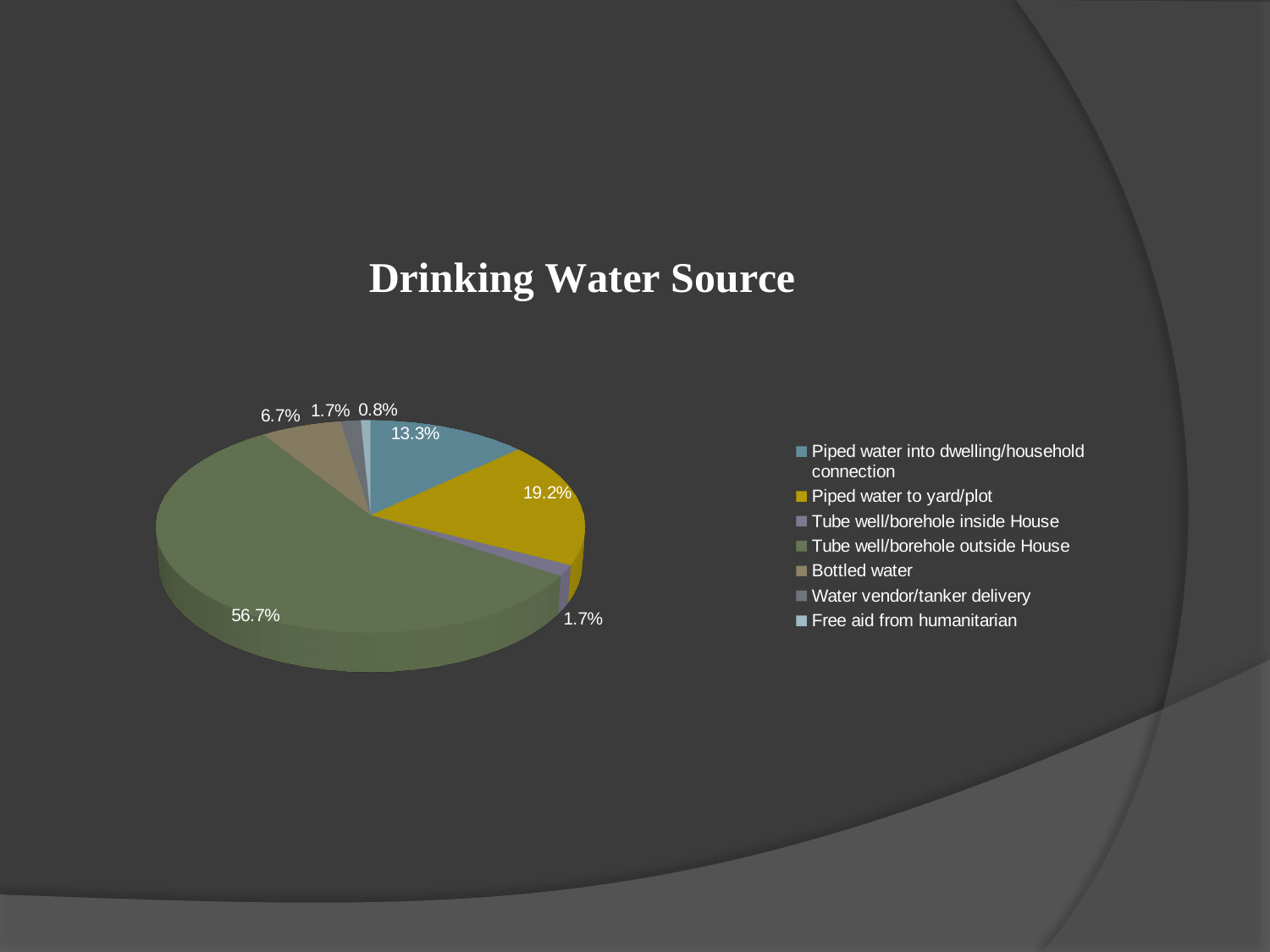
What share of the pie is Tube well/borehole outside House? 56.7% What type of chart is shown on the slide? pie chart What is the difference between the shares for Tube well/borehole outside House and Piped water to yard/plot? 37.5% Which drinking water source has the smallest share of the pie? Free aid from humanitarian What is the title of the chart? Drinking Water Source How many categories does the legend list? 7 Which drinking water source has the largest share of the pie? Tube well/borehole outside House What share of the pie is Free aid from humanitarian? 0.8% What share of the pie is Bottled water? 6.7% Which is larger, the share for Piped water to yard/plot or the share for Piped water into dwelling/household connection? Piped water to yard/plot